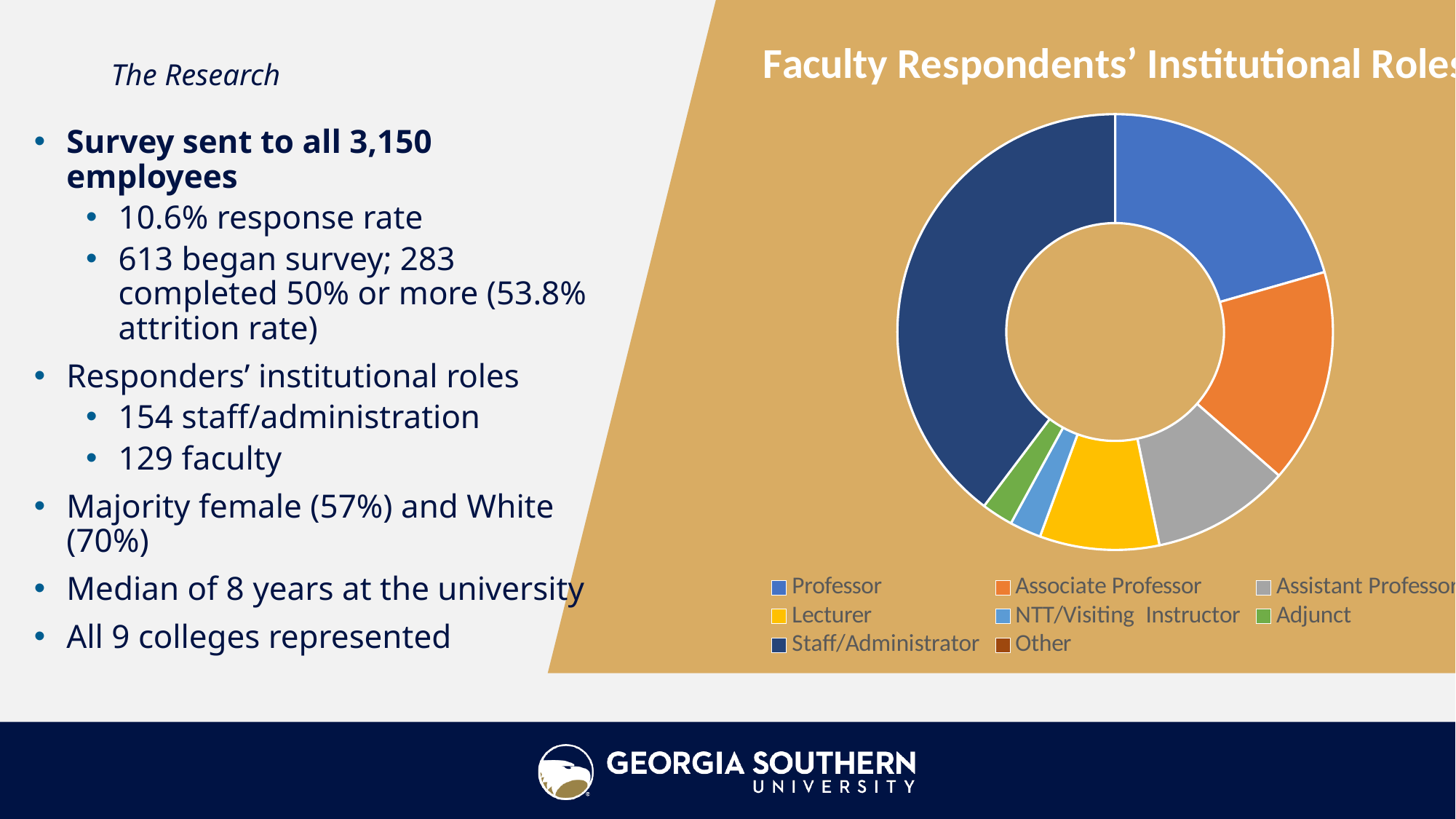
Which slice is larger, Staff/Administrator or Professor? Staff/Administrator Which slice is larger, Professor or Lecturer? Professor What kind of chart is shown on the slide? Doughnut (pie) chart Which slice is larger, Assistant Professor or NTT/Visiting Instructor? Assistant Professor What colour represents the Lecturer category in the chart? Yellow How many categories does the chart's legend list? 8 What is the title of the chart? Faculty Respondents' Institutional Roles Which category has the largest slice of the chart? Staff/Administrator